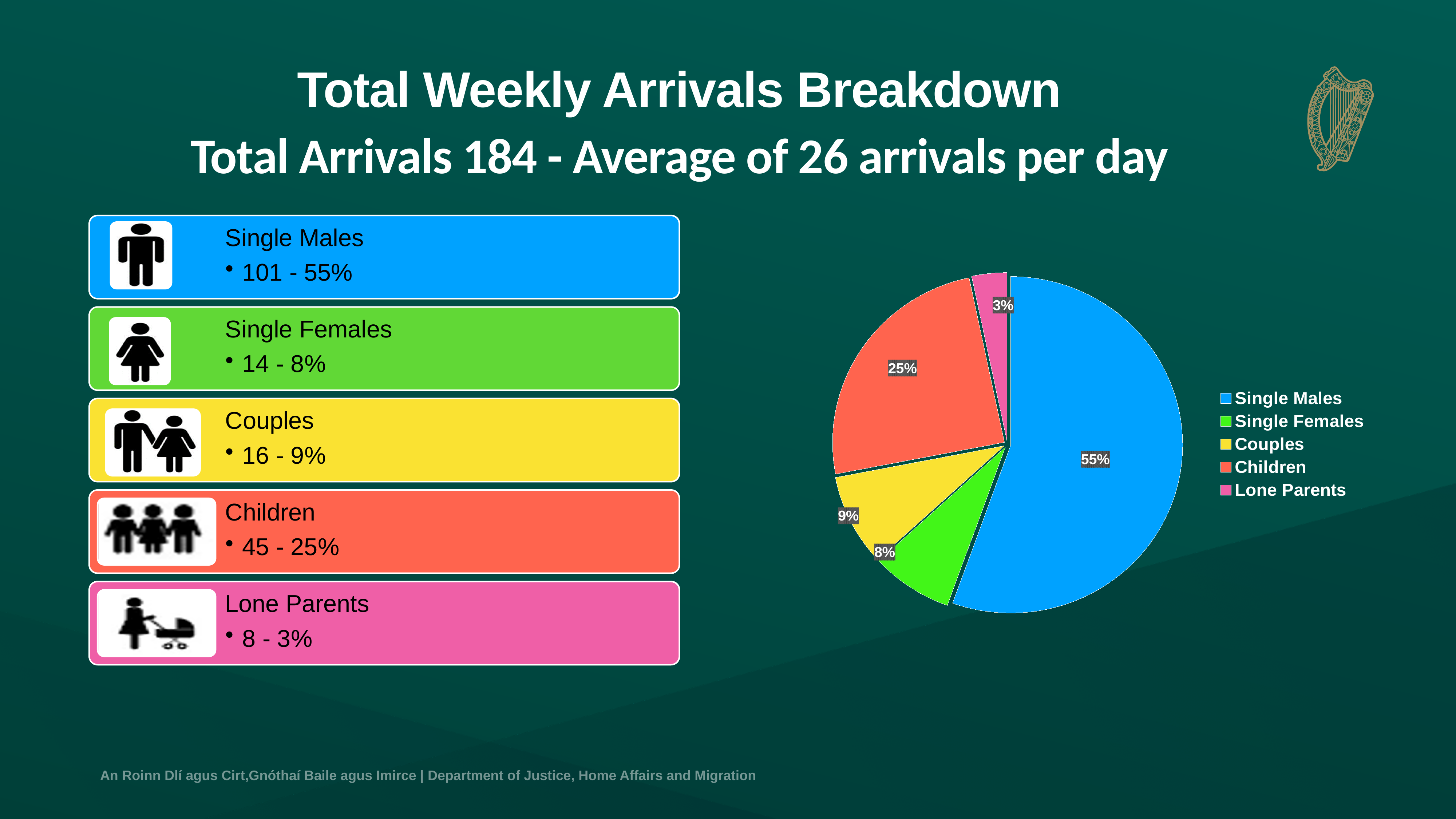
What is the difference in percentage points between the Single Males slice and the Children slice? 30 Which slice is larger in the pie chart, Children or Couples? Children What colour is the Children slice in the pie chart? Orange-red What share of the pie chart does Single Females represent? 8% How many categories does the pie chart show? 5 What share of the pie chart does Couples represent? 9% What share of the pie chart does Single Males represent? 55% Which category has the smallest slice in the pie chart? Lone Parents Which category has the largest slice in the pie chart? Single Males What kind of chart is shown on the slide? Pie chart